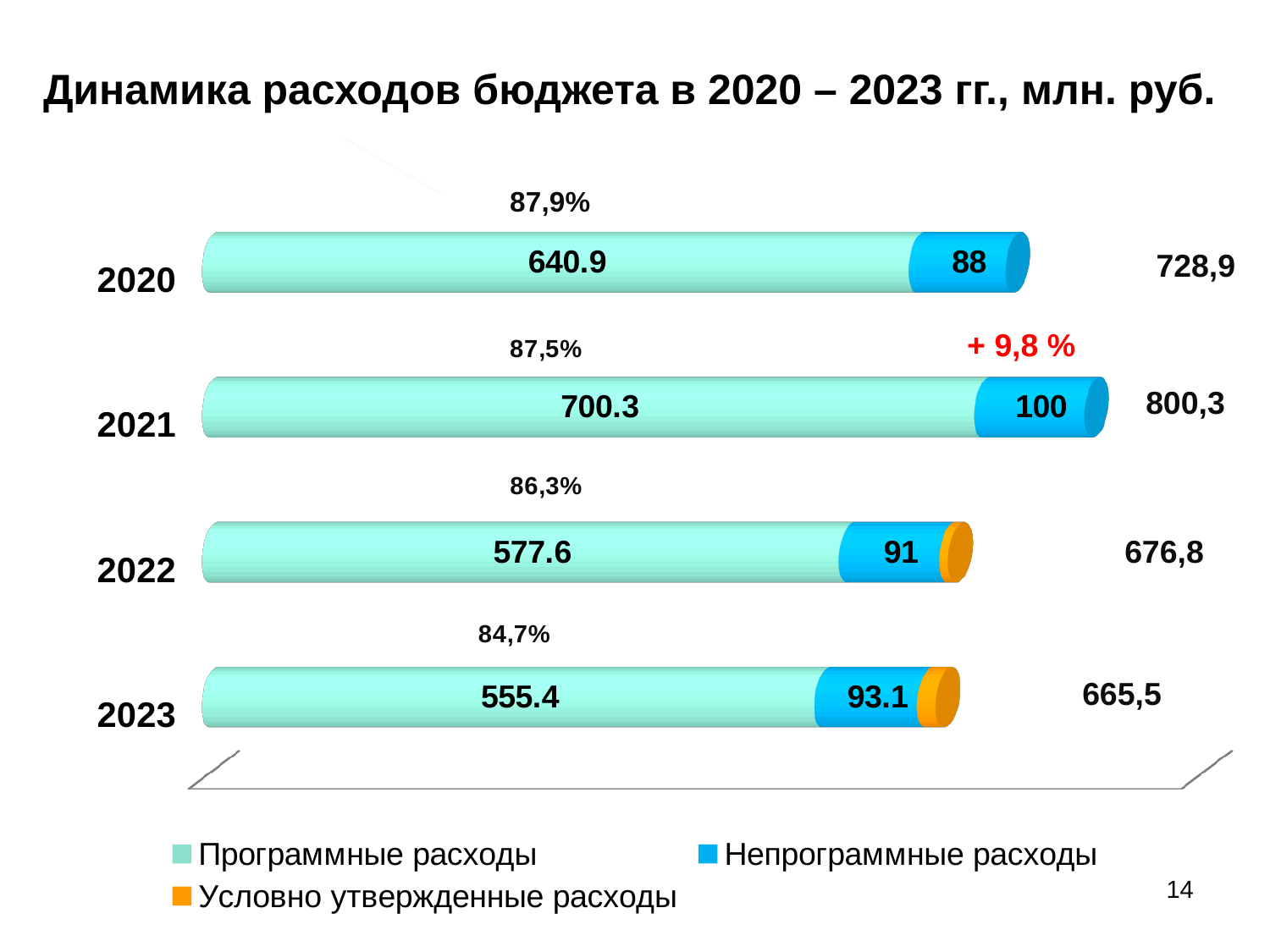
Which year has the highest value of Программные расходы? 2021 How many years are shown on the chart? 4 What is the value of Программные расходы for 2022? 577.6 What total is shown next to the bar for 2021? 800,3 What type of chart is shown on the slide? bar chart What percentage is shown above the bar for 2023? 84,7% Which year has the lowest value of Непрограммные расходы? 2020 What is the value of Непрограммные расходы for 2023? 93.1 What is the difference between Программные расходы in 2021 and 2020? 59.4 How many series does the legend list? 3 Which is larger: Непрограммные расходы in 2022 or in 2023? 2023 What is the value of Программные расходы for 2021? 700.3